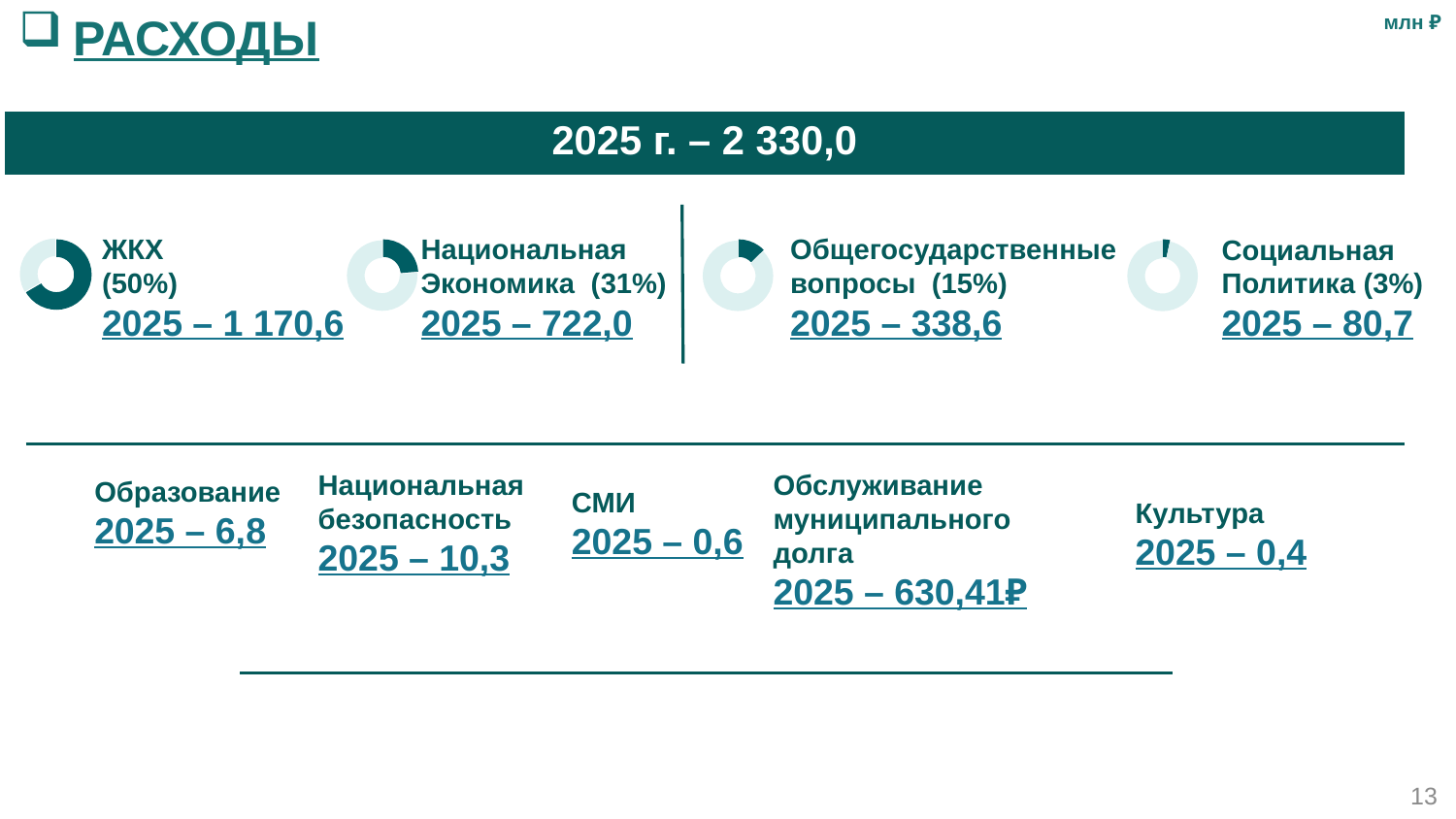
In the Национальная Экономика donut chart, what share is shown? 31% Which share is larger: Национальная Экономика or Общегосударственные вопросы? Национальная Экономика How many small donut charts are shown on the slide? 4 What kind of chart is used next to the ЖКХ label? Donut (pie) chart In the Социальная Политика donut chart, what share is shown? 3% Which of the four donut charts shows the largest share? ЖКХ In the Общегосударственные вопросы donut chart, what share is shown? 15% Which of the four donut charts shows the smallest share? Социальная Политика What is the 2025 value printed next to the ЖКХ donut chart? 1 170,6 What is the 2025 value printed next to the Социальная Политика donut chart? 80,7 What is the 2025 value printed next to the Национальная Экономика donut chart? 722,0